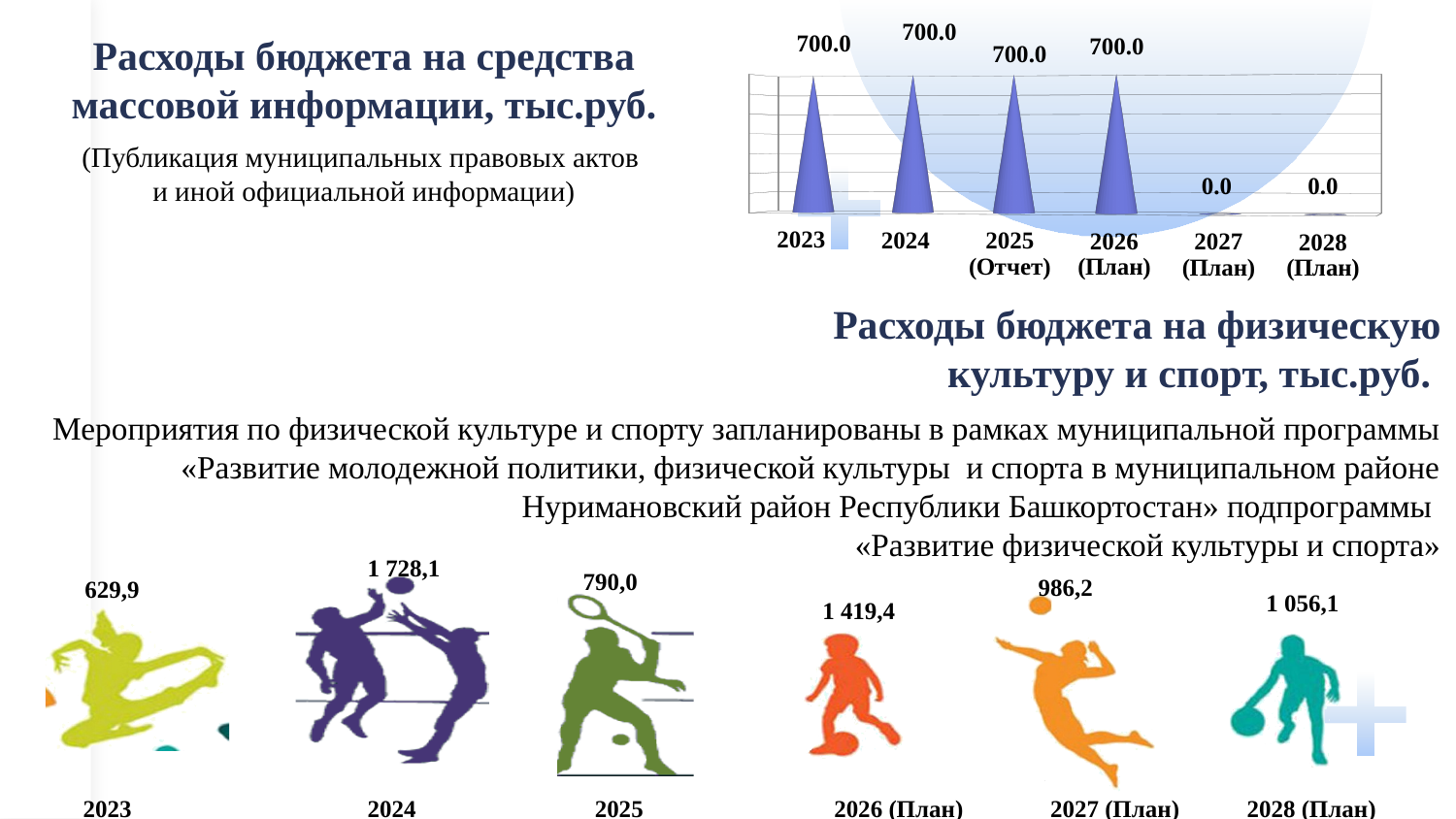
In the chart 'Расходы бюджета на физическую культуру и спорт, тыс.руб.', what is the difference between the values for 2024 and 2023? 1 098,2 In the chart 'Расходы бюджета на средства массовой информации, тыс.руб.', how many years are shown on the x axis? 6 In the chart 'Расходы бюджета на физическую культуру и спорт, тыс.руб.', how many years are shown? 6 In the chart 'Расходы бюджета на физическую культуру и спорт, тыс.руб.', which year has the highest value? 2024 In the chart 'Расходы бюджета на средства массовой информации, тыс.руб.', what is the difference between the values for 2026 (План) and 2028 (План)? 700.0 In the chart 'Расходы бюджета на физическую культуру и спорт, тыс.руб.', which is larger: the value for 2026 (План) or 2028 (План)? 2026 (План) In the chart 'Расходы бюджета на средства массовой информации, тыс.руб.', what is the value for 2027 (План)? 0.0 In the chart 'Расходы бюджета на физическую культуру и спорт, тыс.руб.', which year has the lowest value? 2023 In the chart 'Расходы бюджета на физическую культуру и спорт, тыс.руб.', what is the value for 2024? 1 728,1 In the chart 'Расходы бюджета на физическую культуру и спорт, тыс.руб.', what is the value for 2027 (План)? 986,2 In the chart 'Расходы бюджета на средства массовой информации, тыс.руб.', what is the value for 2023? 700.0 In the chart 'Расходы бюджета на средства массовой информации, тыс.руб.', do the values rise or fall from 2026 (План) to 2027 (План)? fall